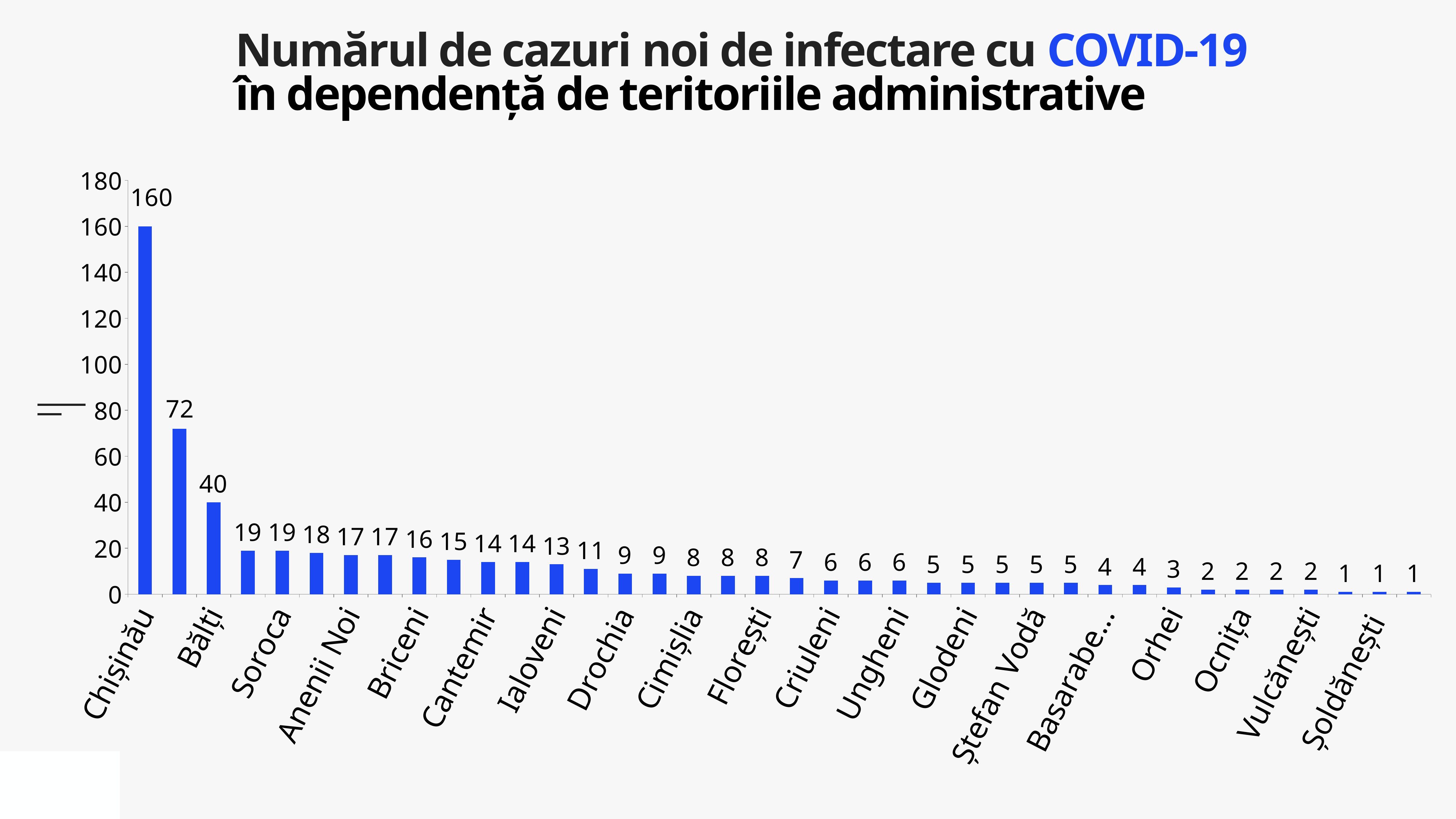
What is the difference between the number of new cases in Chișinău and in Bălți? 120 Do the values rise or fall from left to right along the x axis? fall What is the highest value shown on the vertical axis? 180 What is the number of new cases for Bălți? 40 Which administrative territory has the highest number of new COVID-19 cases? Chișinău Which has more new cases, Chișinău or Bălți? Chișinău What is the number of new cases for Soroca? 19 What is the number of new cases for Șoldănești? 1 What kind of chart is shown on the slide? bar chart What is the number of new cases for Chișinău? 160 What is the number of new cases for Orhei? 3 Is the value for Chișinău greater or less than 140? greater